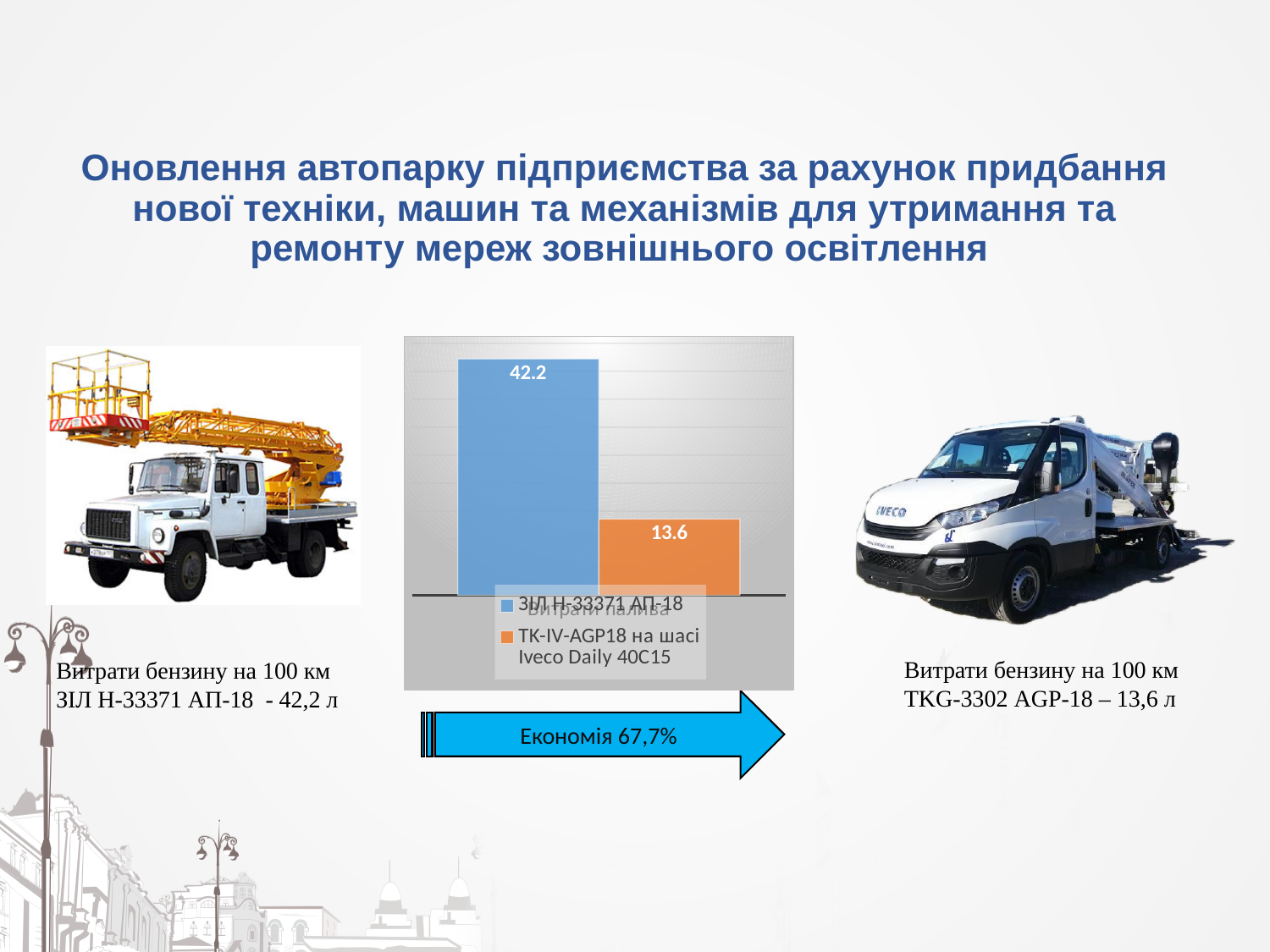
What is the difference between the ЗІЛ Н-33371 АП-18 value and the ТК-IV-AGP18 на шасі Iveco Daily 40C15 value in the bar chart? 28.6 Which series has the higher value in the bar chart? ЗІЛ Н-33371 АП-18 Is the value for ЗІЛ Н-33371 АП-18 larger or smaller than the value for ТК-IV-AGP18 на шасі Iveco Daily 40C15? larger How many series does the legend of the bar chart list? 2 What kind of chart is shown on the slide? bar chart What colour is the bar for ЗІЛ Н-33371 АП-18 in the chart? blue Which series has the lower value in the bar chart? ТК-IV-AGP18 на шасі Iveco Daily 40C15 What value is shown for the ТК-IV-AGP18 на шасі Iveco Daily 40C15 series in the bar chart? 13.6 What value is shown for the ЗІЛ Н-33371 АП-18 series in the bar chart? 42.2 What colour is the bar for ТК-IV-AGP18 на шасі Iveco Daily 40C15 in the chart? orange How many bars are plotted in the chart? 2